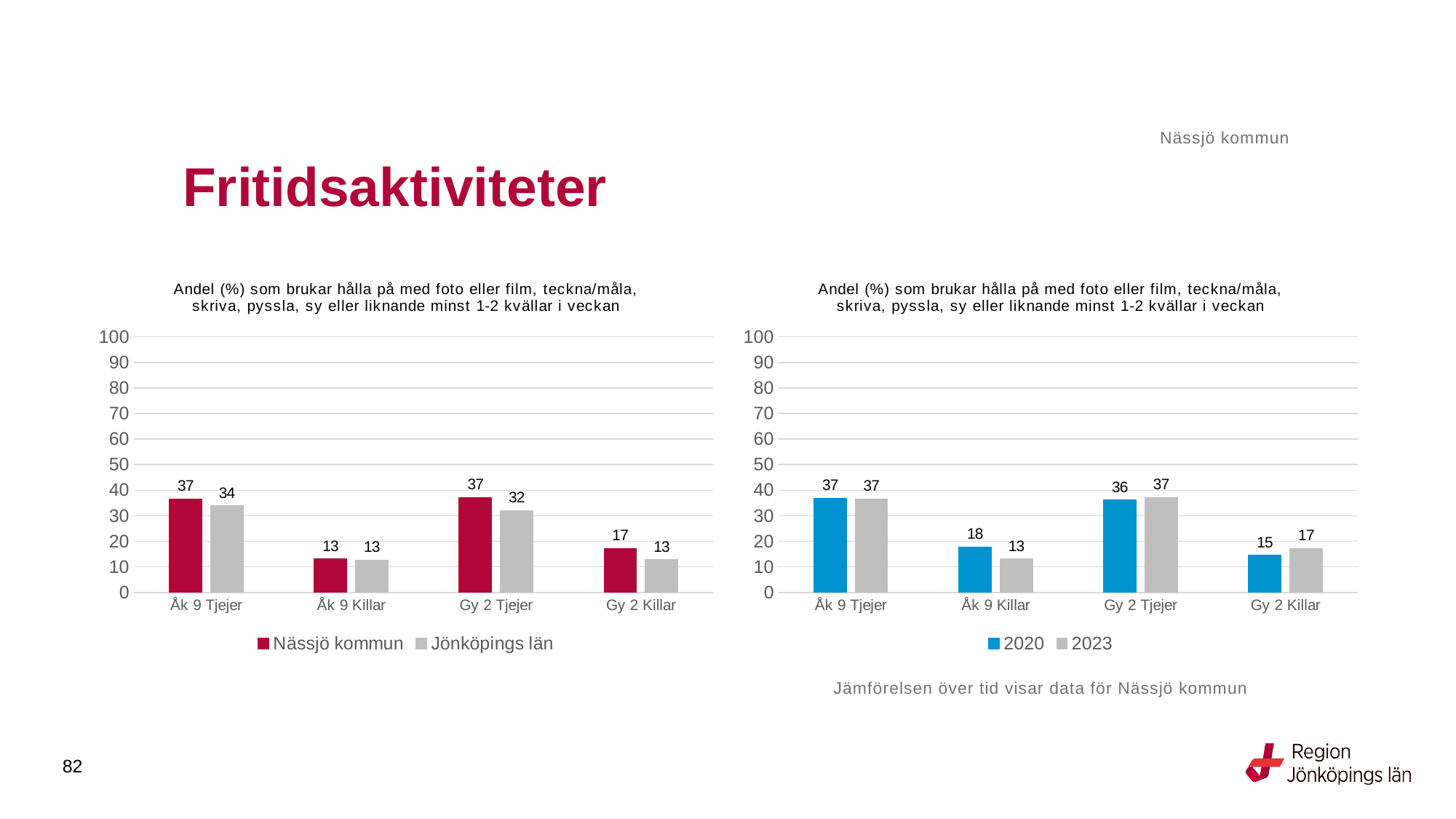
In the left chart (Nässjö kommun vs Jönköpings län), what is the value for Jönköpings län for Gy 2 Tjejer? 32 In the left chart (Nässjö kommun vs Jönköpings län), how many series does the legend list? 2 In the right chart (2020 vs 2023), which category has the highest value for 2023? Åk 9 Tjejer and Gy 2 Tjejer (both 37) In the left chart (Nässjö kommun vs Jönköpings län), what is the value for Nässjö kommun for Åk 9 Tjejer? 37 In the right chart (2020 vs 2023), what is the difference between the 2020 and 2023 values for Åk 9 Killar? 5 What kind of chart is the left chart (Nässjö kommun vs Jönköpings län)? bar chart In the right chart (2020 vs 2023), what is the value for 2023 for Gy 2 Killar? 17 In the left chart (Nässjö kommun vs Jönköpings län), which category has the lowest value for Jönköpings län? Åk 9 Killar and Gy 2 Killar (both 13) How many categories are shown on the x axis of the right chart (2020 vs 2023)? 4 In the left chart (Nässjö kommun vs Jönköpings län), what is the difference between Nässjö kommun and Jönköpings län for Gy 2 Tjejer? 5 In the right chart (2020 vs 2023), what is the value for 2020 for Åk 9 Killar? 18 In the right chart (2020 vs 2023), is the 2020 value for Åk 9 Killar larger or smaller than the 2023 value? larger